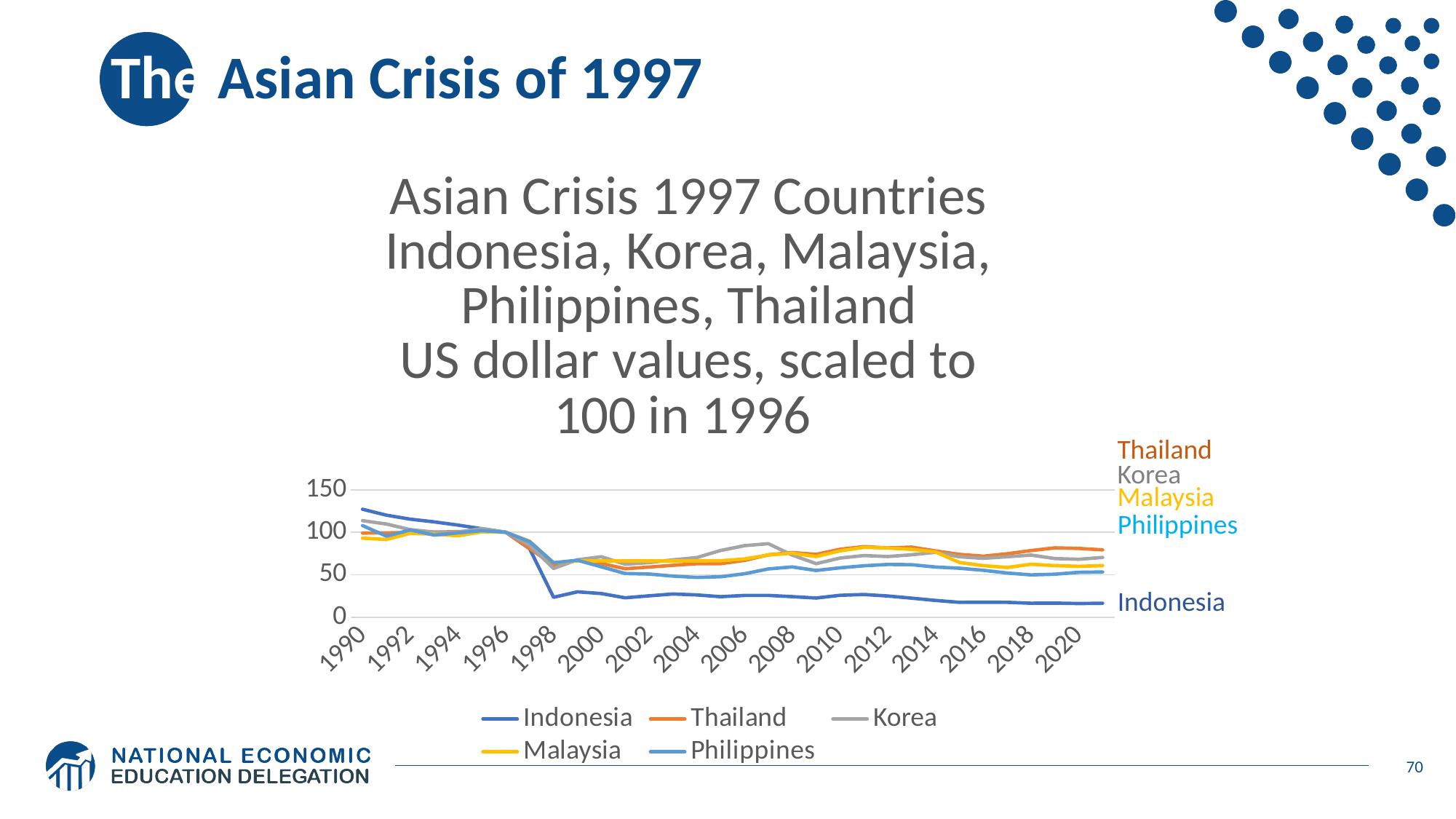
Which country has the highest value in 1990? Indonesia Which country has the lowest value in 2020? Indonesia Is the value for Thailand in 2020 greater or less than 50? greater Is the value for Indonesia in 1990 greater or less than 100? greater Which countries are listed in the chart's legend? Indonesia, Thailand, Korea, Malaysia, Philippines Is the value for Indonesia in 2020 greater or less than 50? less In 2020, is the value for Thailand larger or smaller than the value for Indonesia? larger What is the value for Indonesia in 1996? 100 Does the value for Indonesia rise or fall between 1996 and 1998? fall What kind of chart is shown on the slide? line chart According to the chart title, in which year are the US dollar values scaled to 100? 1996 How many series does the chart's legend list? 5